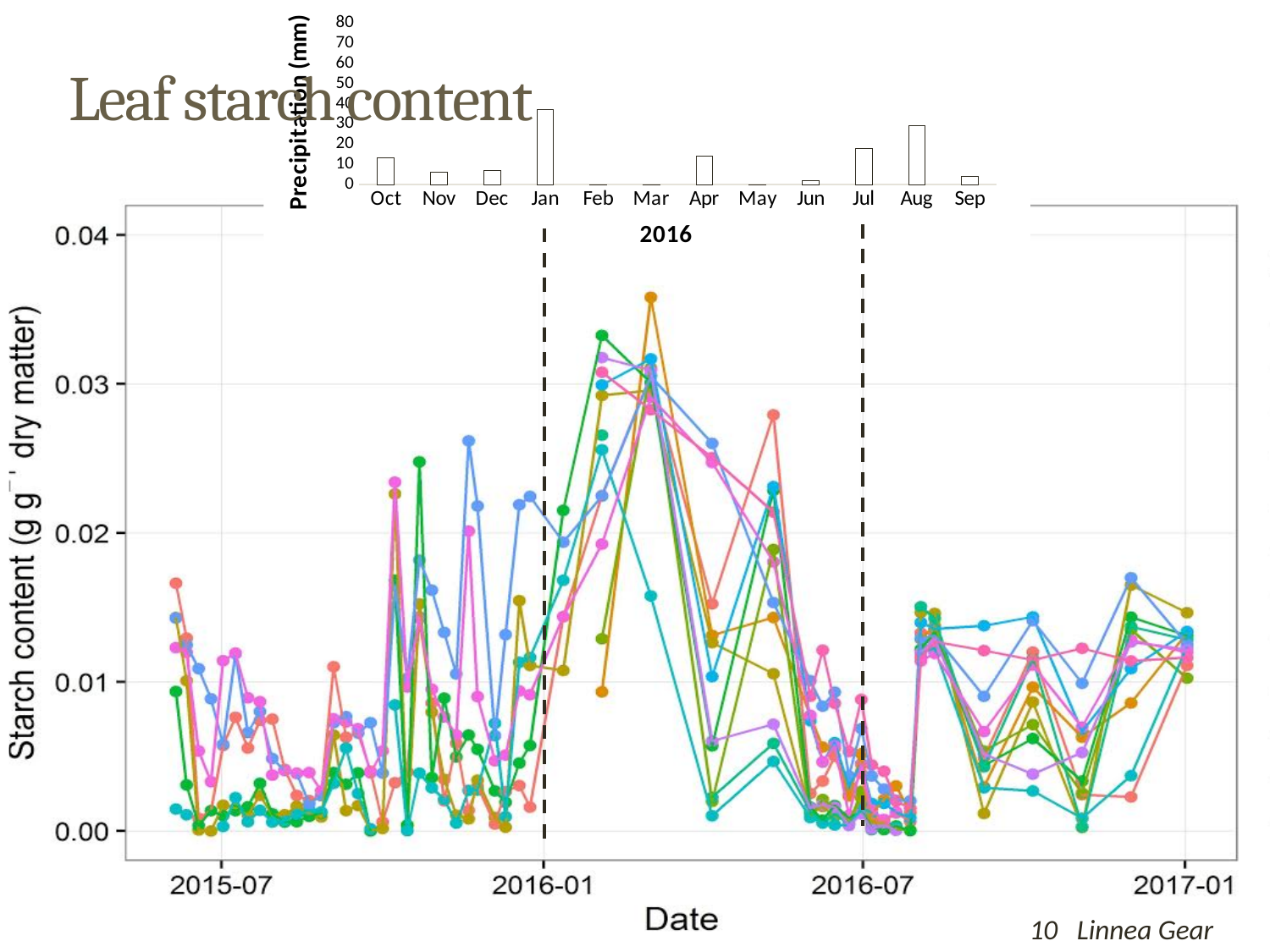
In the precipitation bar chart at the top of the slide, which month has the highest precipitation? Jan What kind of chart is the large starch content chart on the slide? line chart How many months are shown on the x axis of the precipitation bar chart at the top of the slide? 12 What kind of chart is the precipitation chart at the top of the slide? bar chart What is the y-axis label of the precipitation chart at the top of the slide? Precipitation (mm) In the precipitation bar chart at the top of the slide, is the value for Jan greater or less than 30? greater In the large starch content chart, is the highest plotted value greater or less than 0.03? greater In the precipitation bar chart at the top of the slide, is the value for Aug greater or less than 20? greater In the precipitation bar chart at the top of the slide, which has higher precipitation, Jul or Aug? Aug What is the x-axis label of the large starch content chart? Date In the precipitation bar chart at the top of the slide, which has higher precipitation, Jan or Aug? Jan